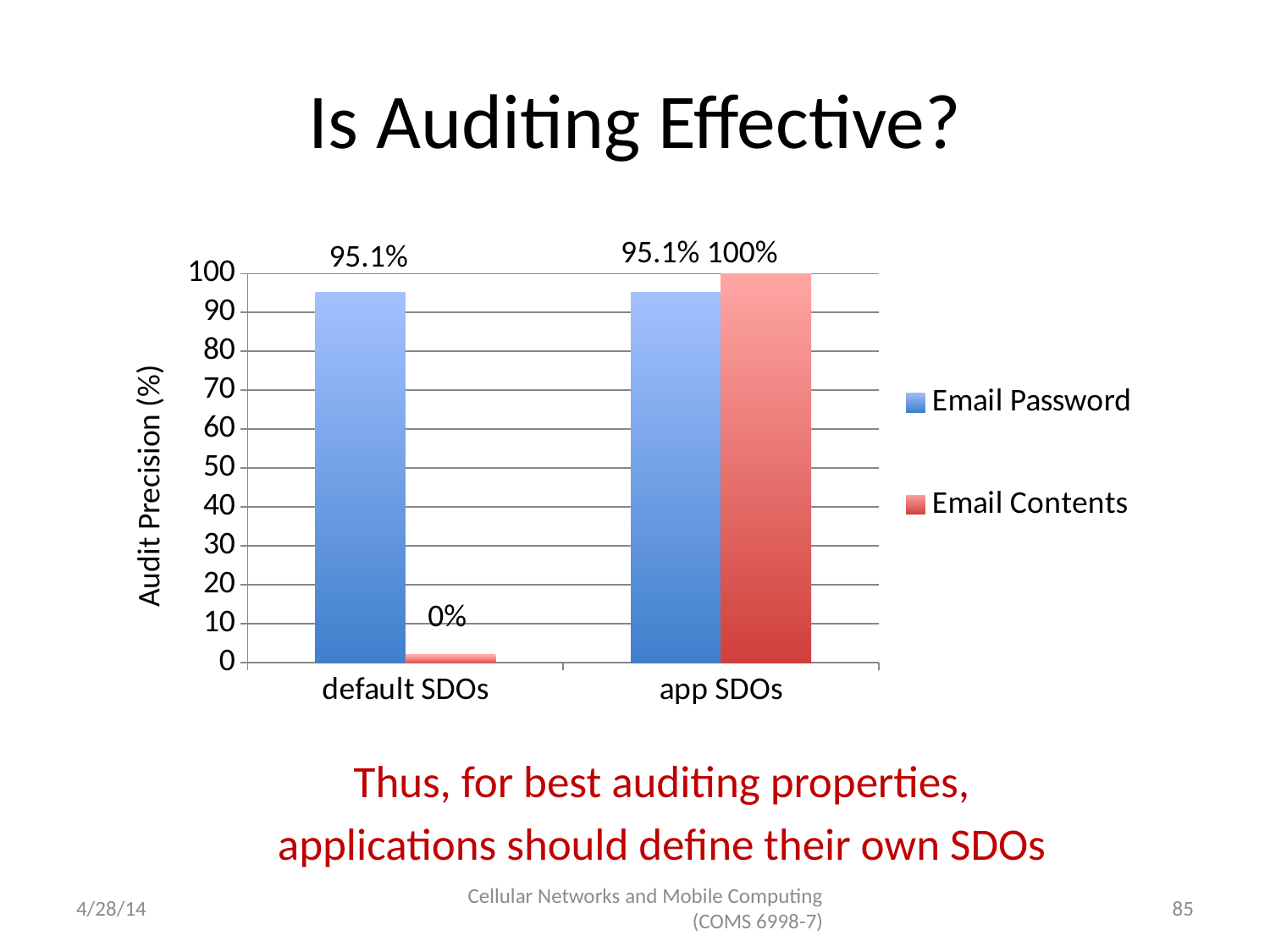
What is the audit precision for Email Password with app SDOs? 95.1% What is the audit precision for Email Contents with default SDOs? 0% How many series does the chart's legend list? 2 For app SDOs, what is the difference between the Email Contents and Email Password audit precision? 4.9% For the Email Contents series, which category has the lower audit precision? default SDOs What kind of chart is shown on the slide? Bar chart For app SDOs, which is larger: the Email Password value or the Email Contents value? Email Contents How many categories are shown on the x axis of the chart? 2 What is the difference in audit precision for Email Contents between app SDOs and default SDOs? 100% What is the audit precision for Email Contents with app SDOs? 100% What is the audit precision for Email Password with default SDOs? 95.1% For the Email Contents series, which category has the higher audit precision? app SDOs